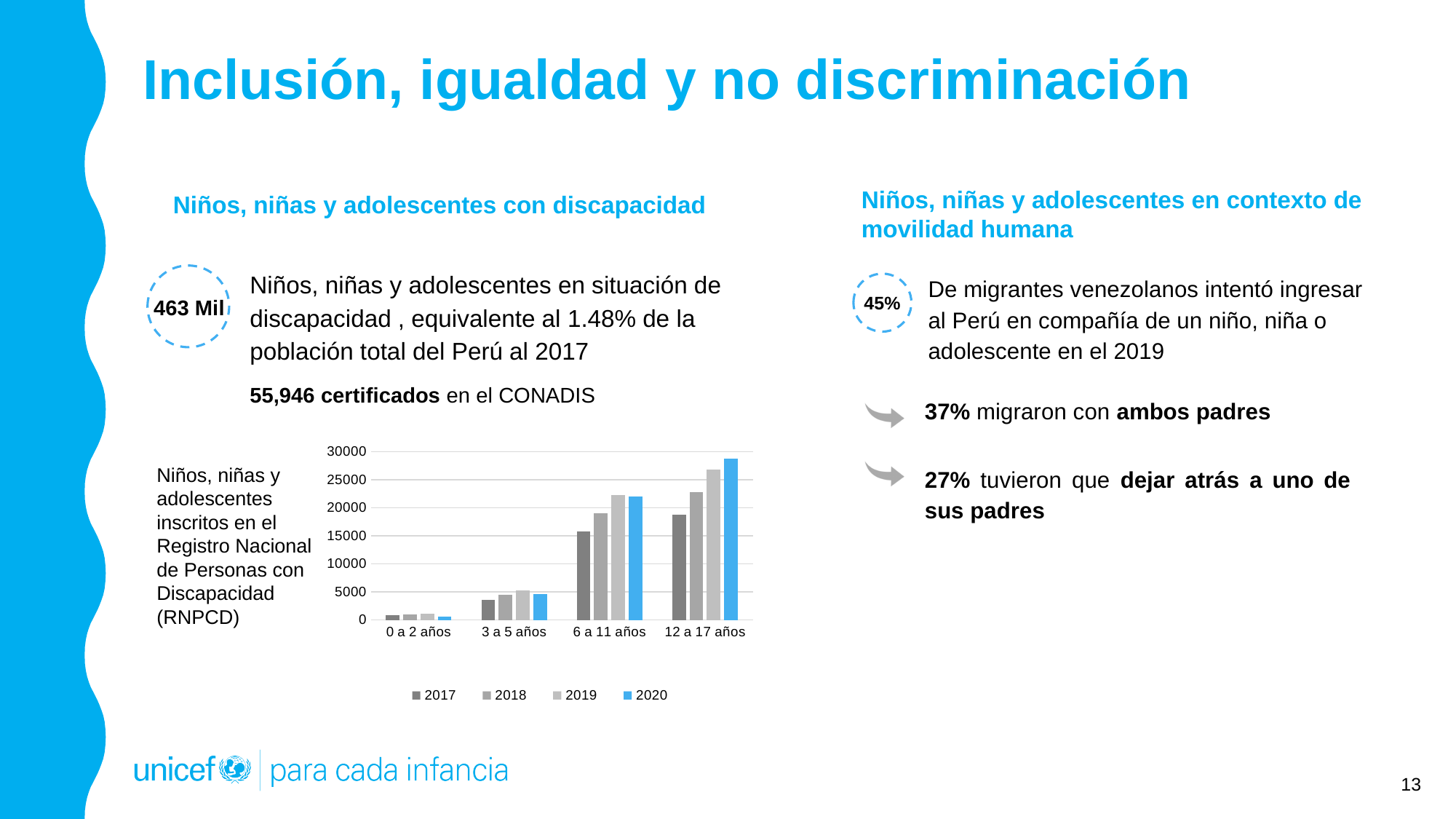
Is the 2017 value for 0 a 2 años greater or less than 5000? less Do the values in the chart generally rise or fall as the age groups move from left to right along the x axis? Rise How many series does the chart's legend list? 4 Is the 2020 value for 12 a 17 años greater or less than 25000? greater Which age group has the highest bars in the chart? 12 a 17 años Is the 2019 value for 6 a 11 años greater or less than 20000? greater What kind of chart is shown on the slide? Bar chart Which years are listed in the chart's legend? 2017, 2018, 2019, 2020 Which age group has the lowest bars in the chart? 0 a 2 años How many age-group categories are shown on the x axis of the chart? 4 For the 3 a 5 años group, which is larger: the 2017 value or the 2020 value? 2020